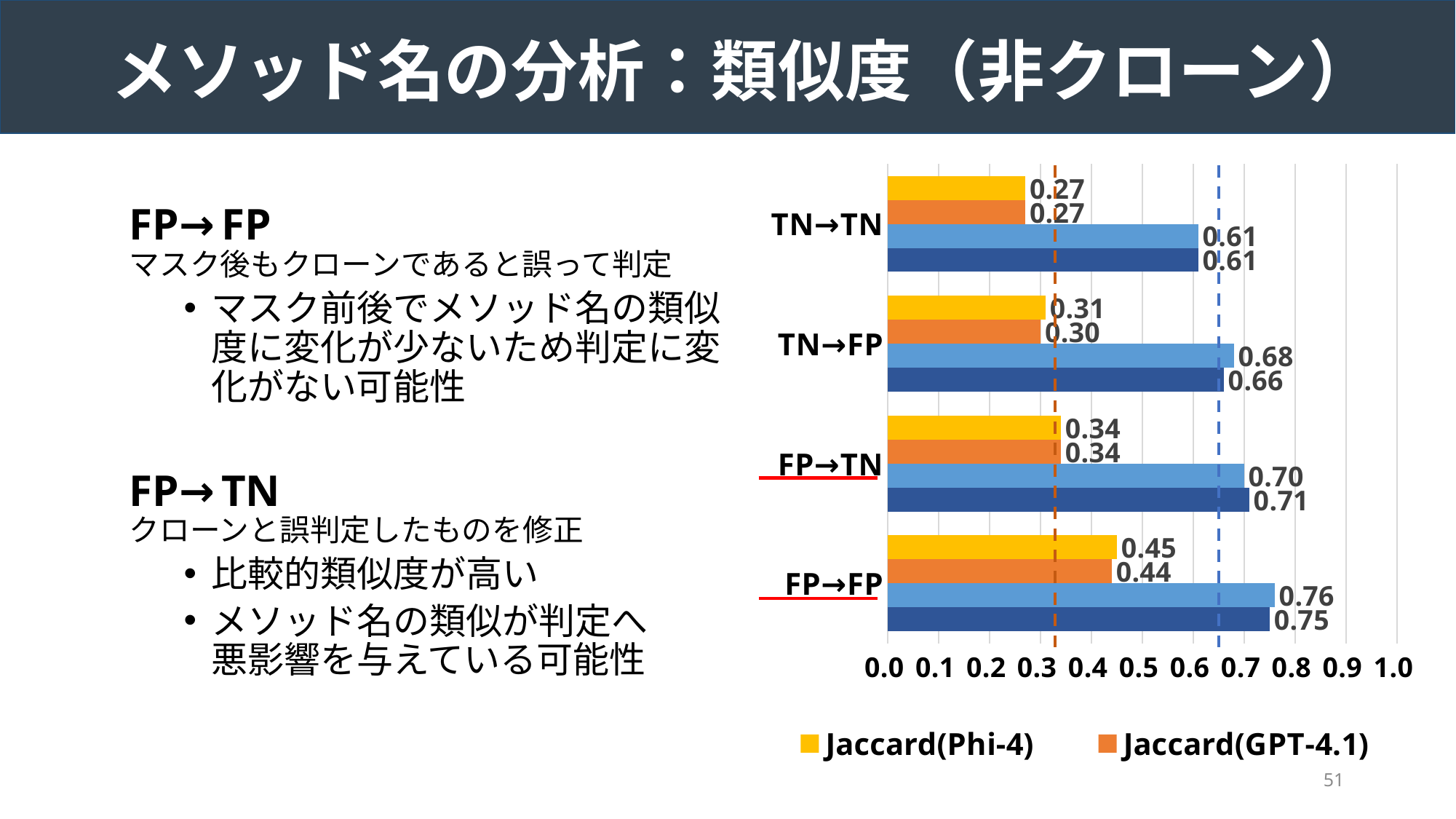
What is the difference between the Jaccard(GPT-4.1) values for FP→FP and FP→TN? 0.10 Which has the larger Jaccard(Phi-4) value, FP→TN or TN→FP? FP→TN What is the Jaccard(GPT-4.1) value for FP→TN? 0.34 Which category has the highest Jaccard(Phi-4) value? FP→FP What is the difference between the Jaccard(Phi-4) values for FP→FP and TN→TN? 0.18 What kind of chart is shown on the slide? bar chart Is the Jaccard(Phi-4) value for FP→FP greater or less than 0.5? less How many series does the chart's legend list? 2 Which category has the lowest Jaccard(GPT-4.1) value? TN→TN What is the Jaccard(Phi-4) value for FP→FP? 0.45 How many categories are shown on the chart's vertical axis? 4 What is the Jaccard(GPT-4.1) value for TN→FP? 0.30